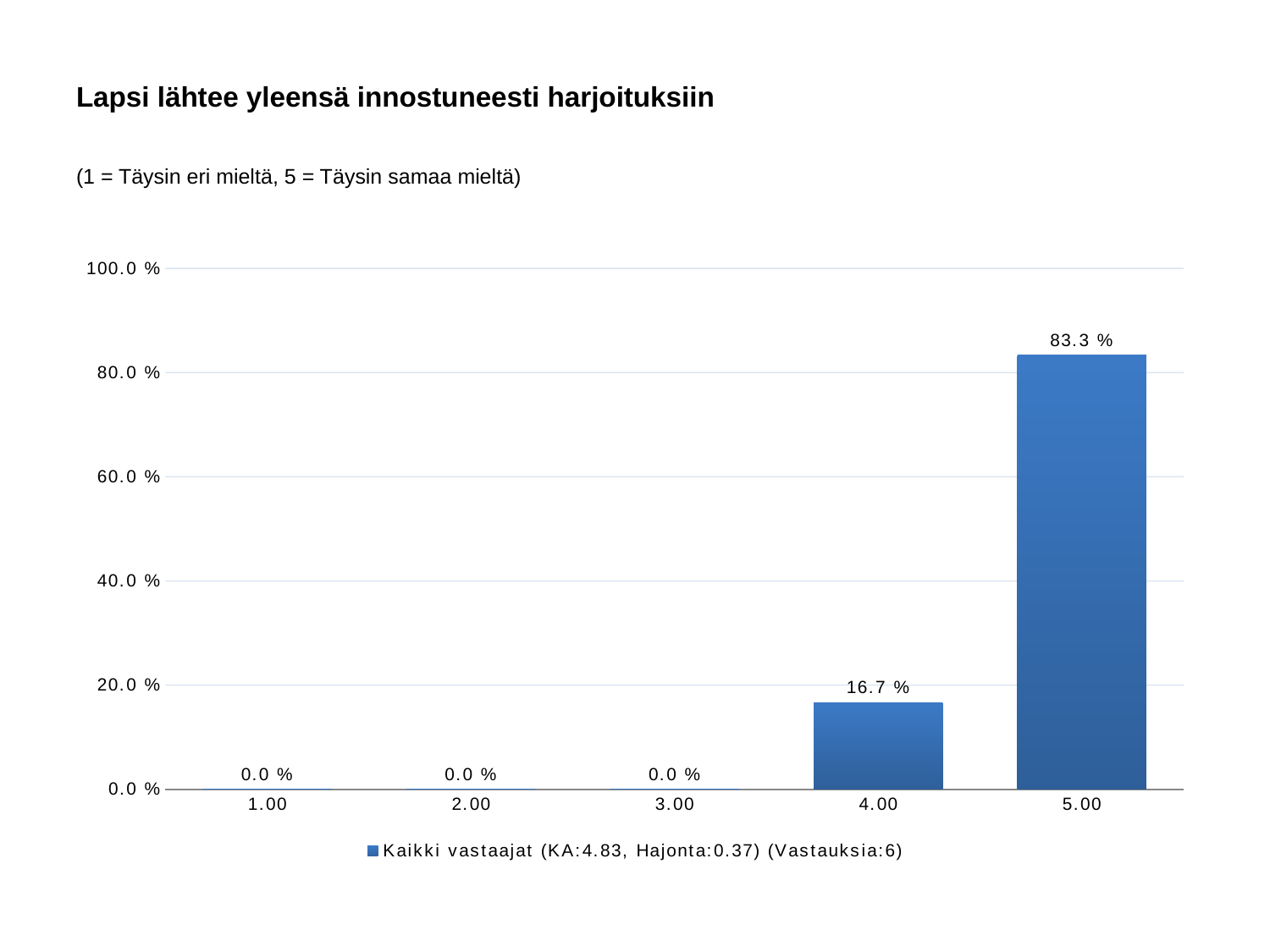
How many categories are shown on the x axis? 5 What is the title of the slide? Lapsi lähtee yleensä innostuneesti harjoituksiin What is the difference between the values for 5.00 and 4.00? 66.6 % Is the value for 5.00 greater or less than 80.0 %? greater What is the value for category 4.00? 16.7 % What is the value for category 5.00? 83.3 % Is the value for 4.00 greater or less than 20.0 %? less How many series does the legend list? 1 What kind of chart is shown? bar chart What is the value for category 1.00? 0.0 % Which category has the highest value? 5.00 Which is larger, the value for 4.00 or the value for 5.00? 5.00